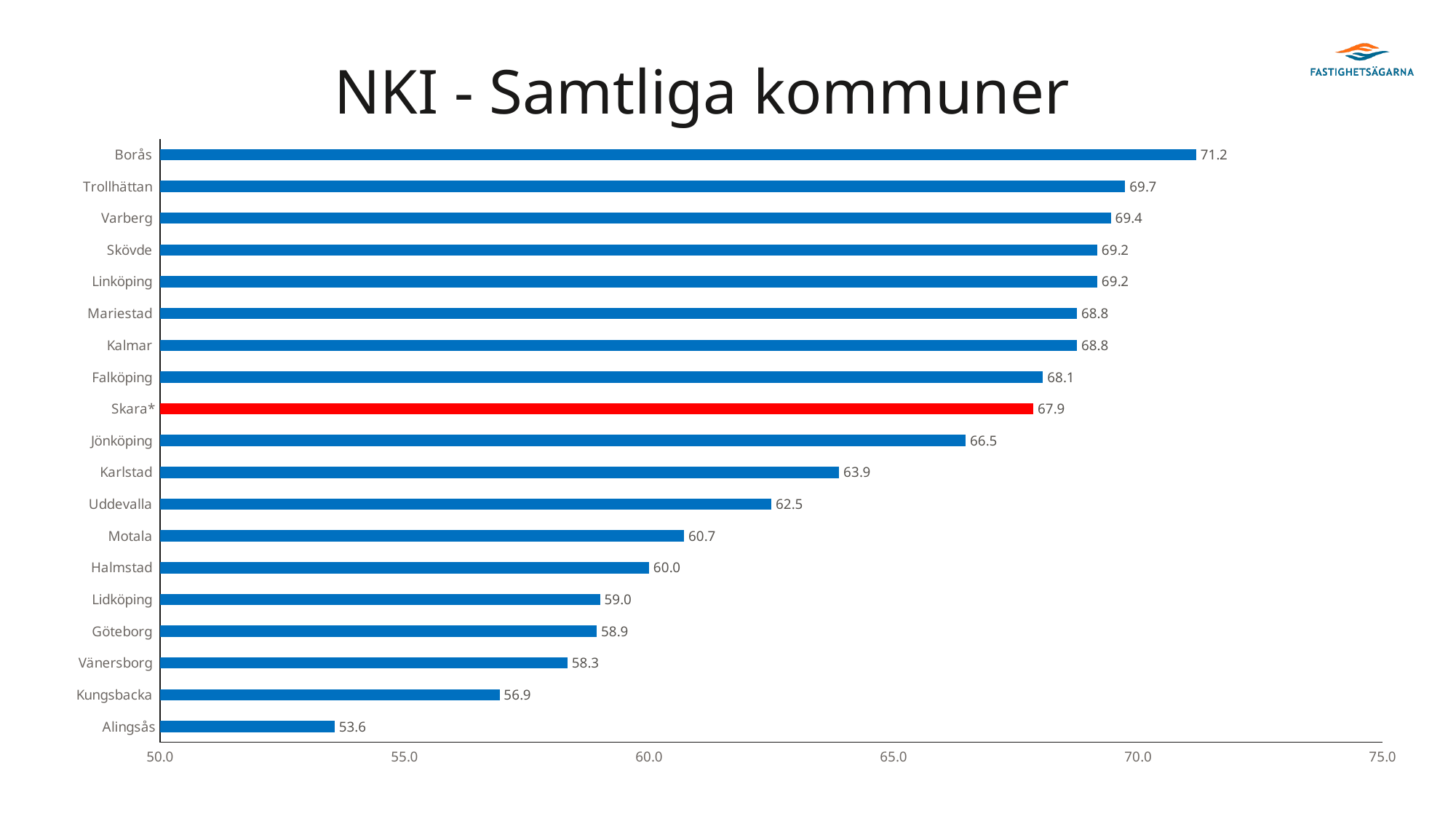
What is the difference between the NKI values of Skara* and Jönköping? 1.4 Which municipality has the lowest NKI value? Alingsås What type of chart is shown on the slide? Bar chart Which municipality has the highest NKI value? Borås What is the NKI value for Skara*? 67.9 What is the difference between the NKI values of Borås and Alingsås? 17.6 Which has a higher NKI value, Karlstad or Uddevalla? Karlstad What is the NKI value for Göteborg? 58.9 What is the NKI value for Kalmar? 68.8 Is the value for Motala greater or less than 60.0? greater Which municipality's bar is highlighted in red? Skara* How many municipalities are shown in the chart? 19